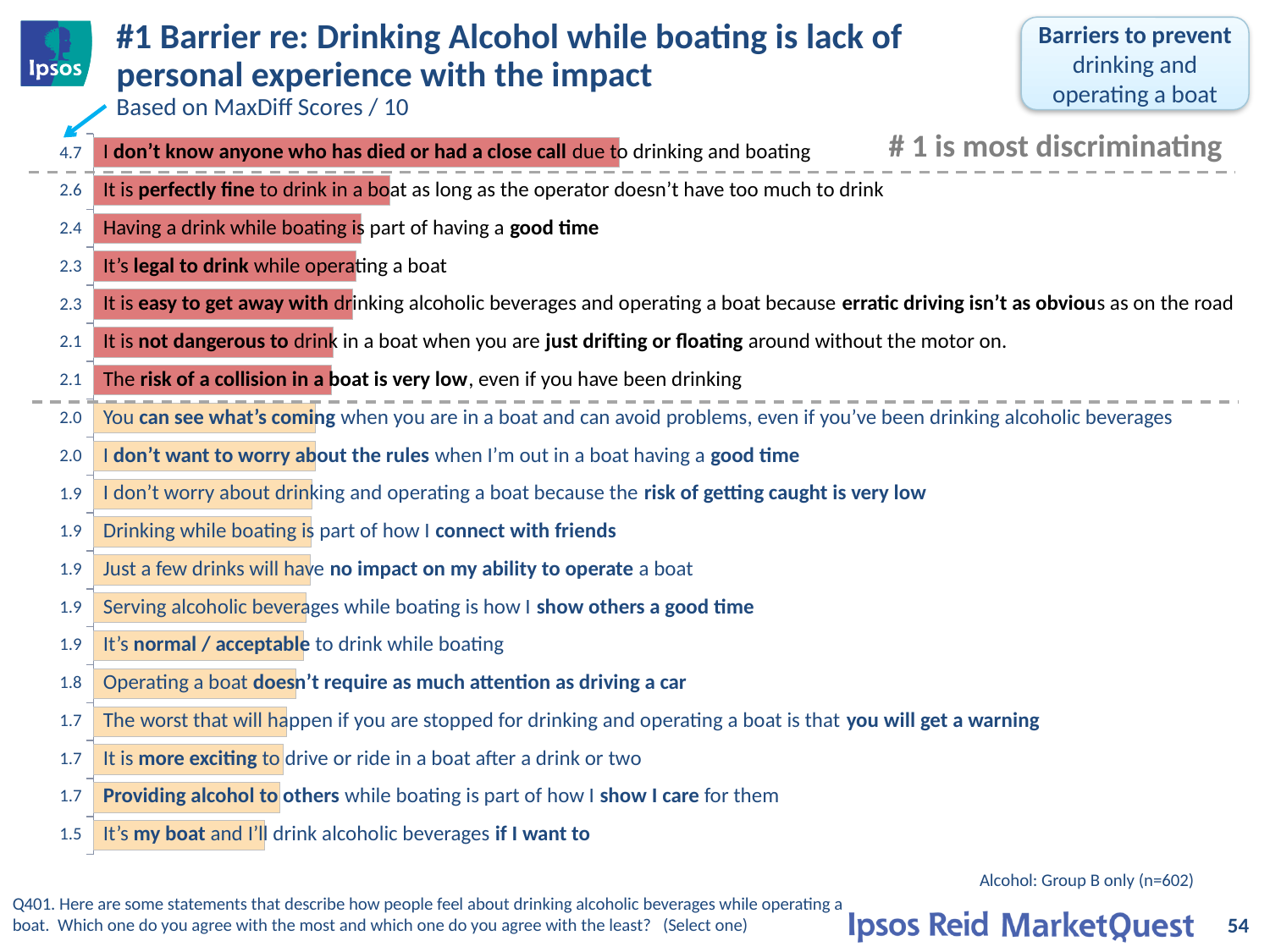
Which has a higher MaxDiff score: "It is perfectly fine to drink in a boat as long as the operator doesn't have too much to drink" or "You can see what's coming when you are in a boat and can avoid problems"? It is perfectly fine to drink in a boat as long as the operator doesn't have too much to drink What is the difference in MaxDiff score between "Having a drink while boating is part of having a good time" and "It's my boat and I'll drink alcoholic beverages if I want to"? 0.9 What is the MaxDiff score for the statement "I don't know anyone who has died or had a close call due to drinking and boating"? 4.7 Do the MaxDiff scores increase or decrease from the top bar to the bottom bar? Decrease What type of chart is used on this slide? Bar chart What is the MaxDiff score for "Operating a boat doesn't require as much attention as driving a car"? 1.8 What colour are the bars for the seven highest-scoring statements above the lower dashed line? Red How many statements (bars) are shown in the chart? 19 Which statement has the lowest MaxDiff score? It's my boat and I'll drink alcoholic beverages if I want to What is the difference between the highest MaxDiff score (4.7) and the second highest (2.6)? 2.1 Which statement has the highest MaxDiff score? I don't know anyone who has died or had a close call due to drinking and boating What is the MaxDiff score for "It's legal to drink while operating a boat"? 2.3